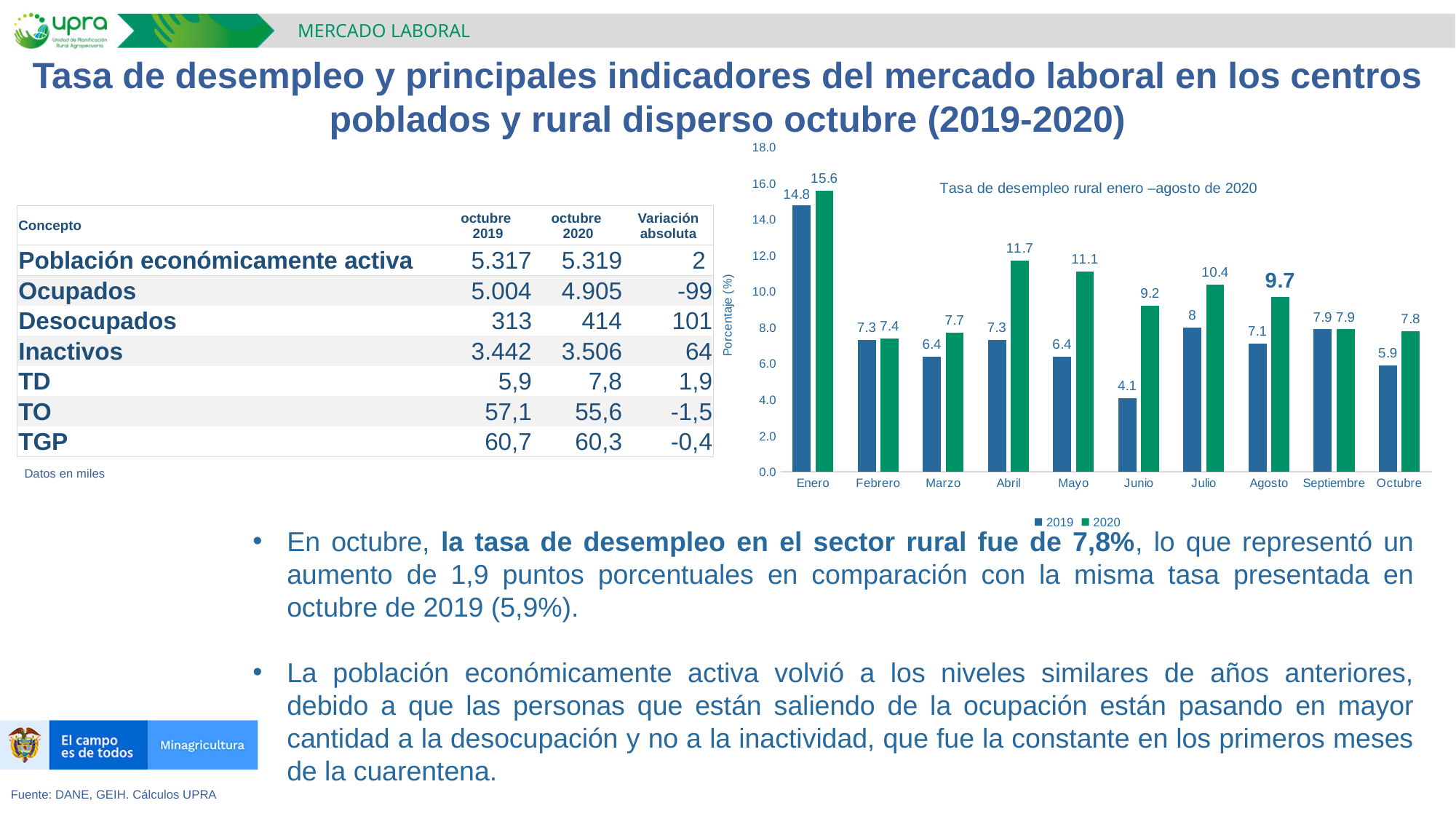
What is the 2020 value for Abril in the chart? 11.7 Which month has the highest 2020 value in the chart? Enero What is the 2019 value for Junio in the chart? 4.1 Which is larger for Julio: the 2019 value or the 2020 value? 2020 What is the difference between the 2020 and 2019 values for Mayo? 4.7 Which month has the lowest 2019 value in the chart? Junio What kind of chart is shown on the slide? bar chart How many months are shown on the x axis of the chart? 10 Is the 2020 value for Junio greater or less than 8.0? greater What is the label of the y axis of the chart? Porcentaje (%) How many series does the chart legend list? 2 What is the 2020 value for Octubre in the chart? 7.8